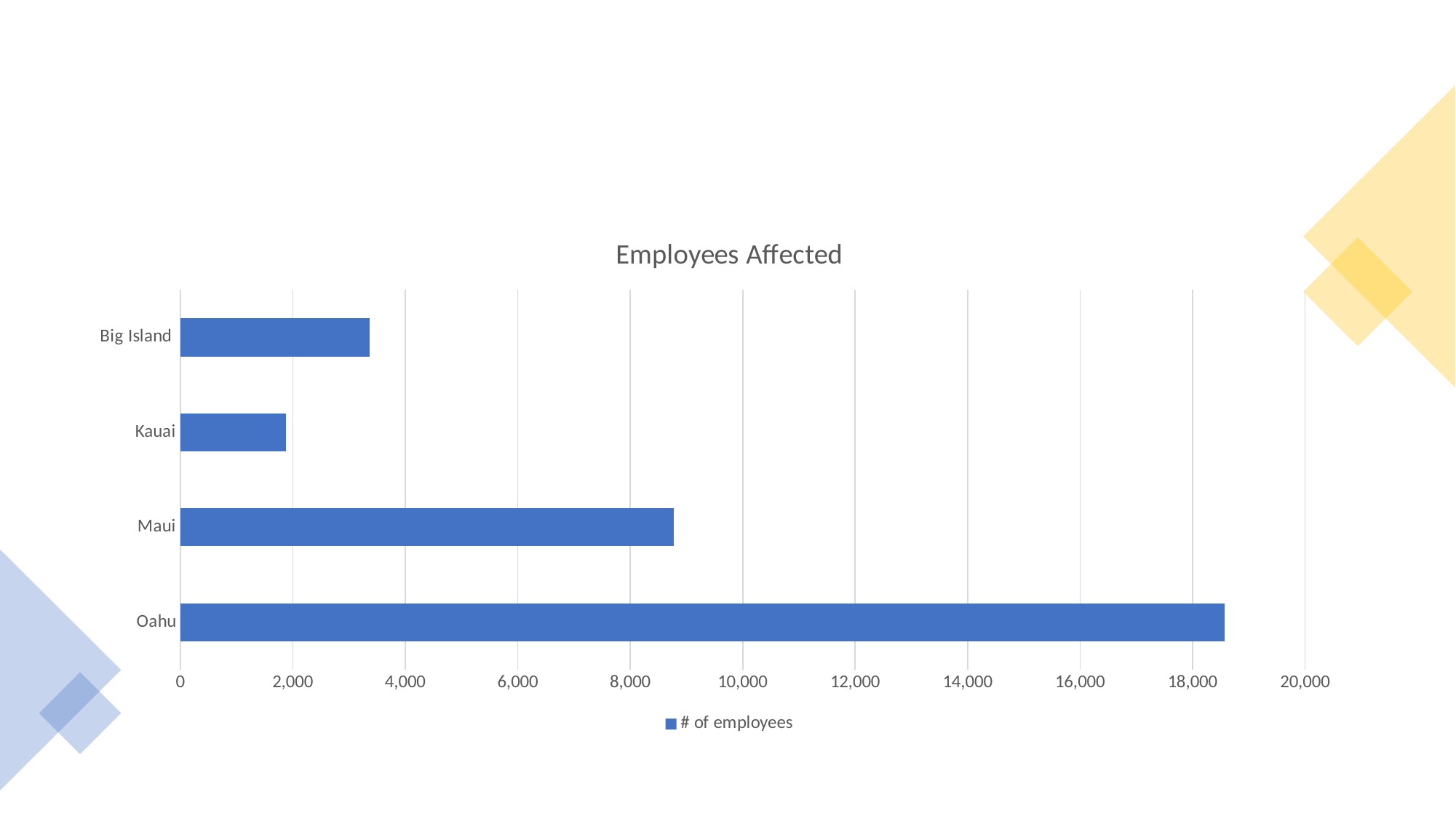
What kind of chart is shown on the slide? bar chart Is the value for Maui greater or less than 10,000? less Is the value for Kauai greater or less than 2,000? less Which island has the lowest number of employees affected? Kauai What is the title of the chart? Employees Affected How many series does the legend list? 1 Which has more employees affected, Maui or Big Island? Maui Which island has the highest number of employees affected? Oahu Is the value for Oahu greater or less than 18,000? greater What is the name of the series shown in the legend? # of employees How many categories (islands) are shown in the chart? 4